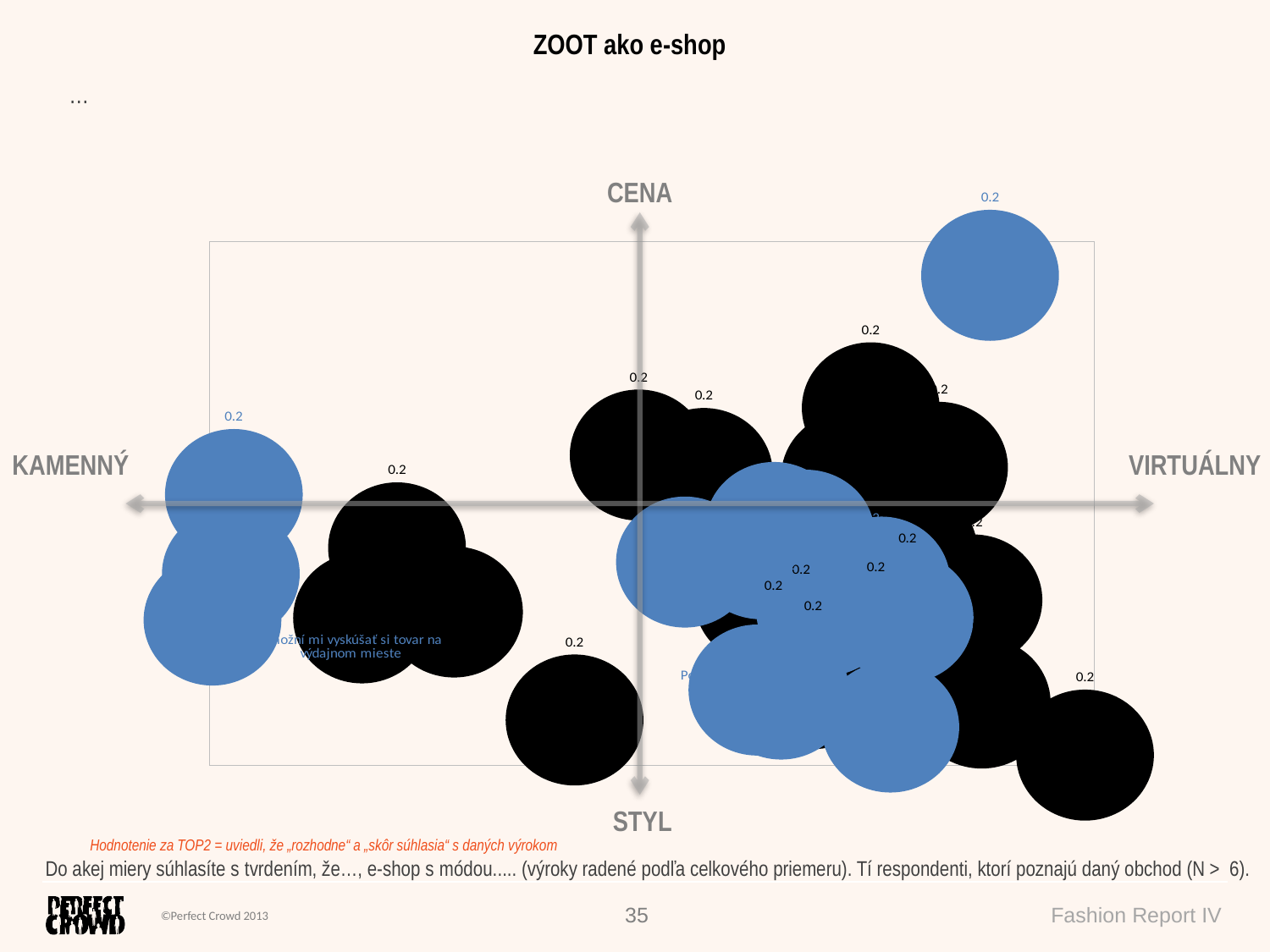
What colour is the bubble positioned furthest toward VIRTUÁLNY on the horizontal axis? black What colour is the bubble positioned furthest toward KAMENNÝ on the horizontal axis? blue What is the title of the chart on the slide? ZOOT ako e-shop What label appears at the top end of the vertical axis? CENA What colour is the bubble positioned lowest toward STYL on the vertical axis? black What value is printed as the data label on the bubble at the far left of the chart? 0.2 What value is printed as the data label on the black bubble at the bottom-right of the chart? 0.2 What colour is the bubble positioned highest toward CENA on the vertical axis? blue What kind of chart is shown on the slide? bubble chart What value is printed as the data label on the blue bubble in the top-right corner of the chart? 0.2